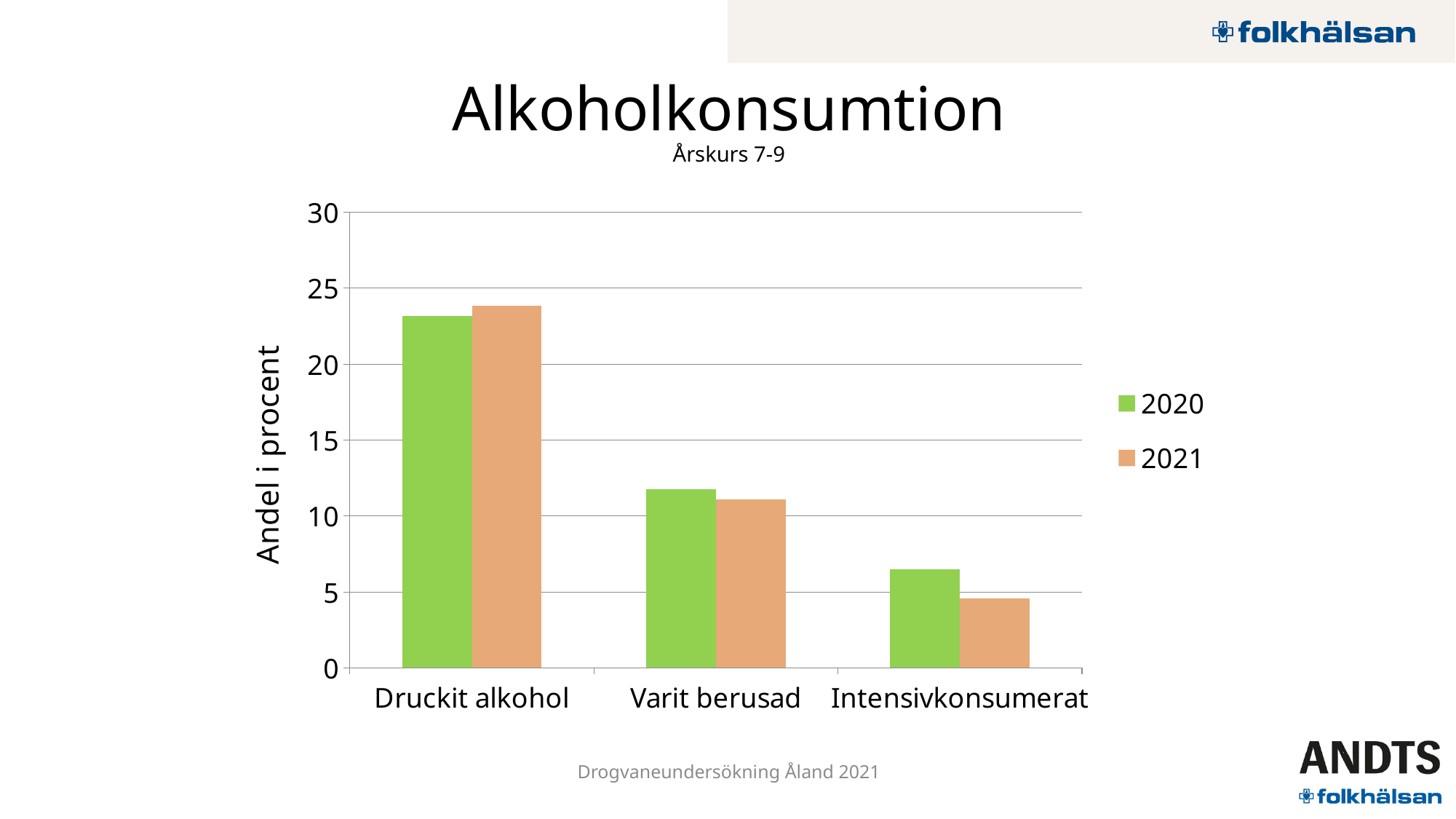
Is the 2020 value for Druckit alkohol greater or less than 20? greater What is the label on the y axis of the chart? Andel i procent Is the 2021 value for Intensivkonsumerat greater or less than 5? less Do the 2020 values rise or fall from left to right across the categories? fall Is the 2020 value for Intensivkonsumerat greater or less than 5? greater Which category has the lowest value for the 2021 series? Intensivkonsumerat How many series does the legend list? 2 What type of chart is shown on the slide? bar chart Which category has the highest value for the 2020 series? Druckit alkohol For Intensivkonsumerat, which series has the larger value, 2020 or 2021? 2020 How many categories are shown on the x axis? 3